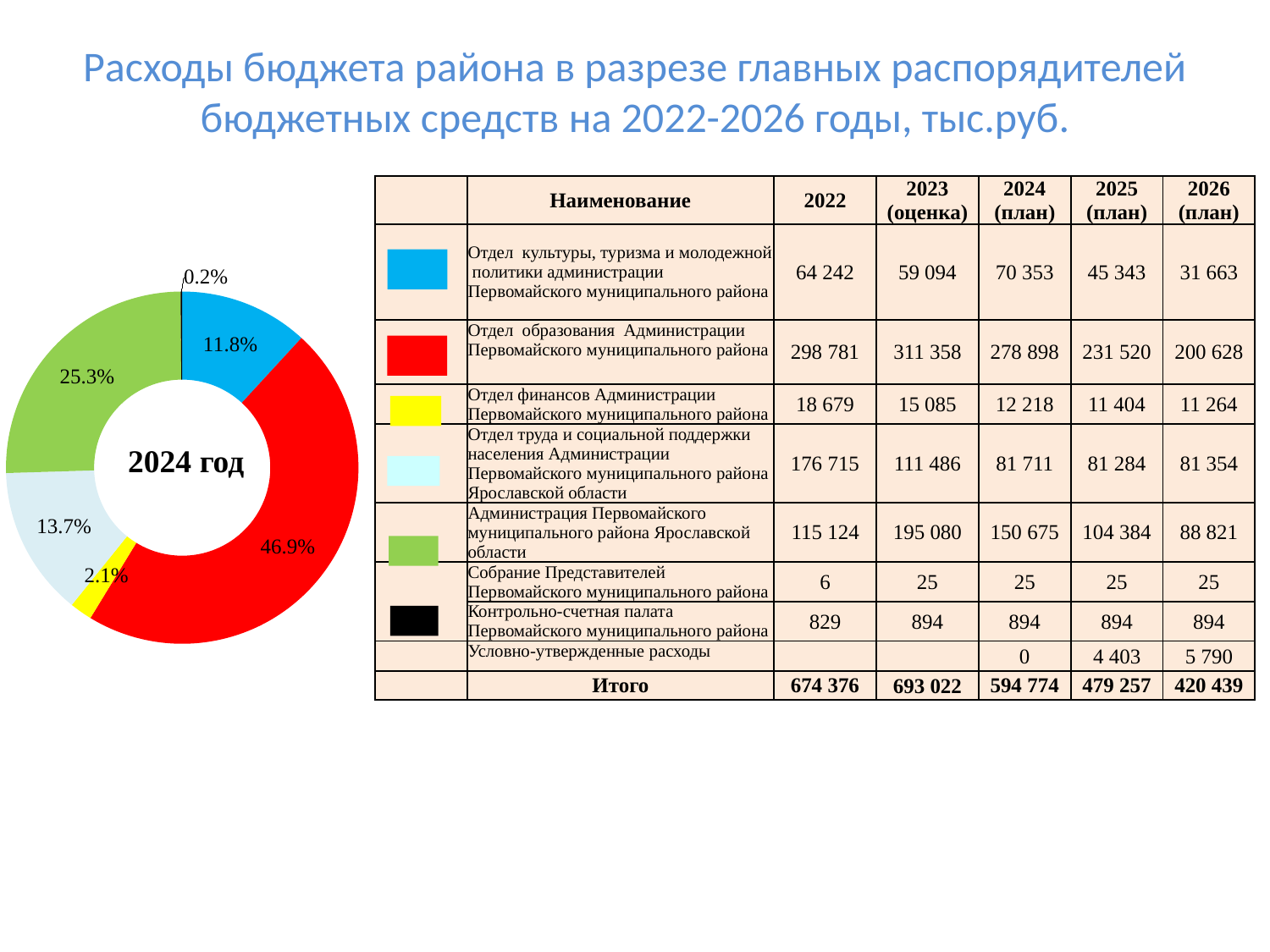
In the doughnut chart, which is larger: the light blue slice or the blue slice? The light blue slice (13.7%) What kind of chart is shown on the left of the slide? Doughnut (pie) chart By how many percentage points does the red slice (46.9%) exceed the green slice (25.3%) in the doughnut chart? 21.6 percentage points What share of the doughnut chart does the green slice (Администрация Первомайского муниципального района) take? 25.3% What share of the doughnut chart does the light blue slice (Отдел труда и социальной поддержки населения) take? 13.7% What share of the doughnut chart does the yellow slice (Отдел финансов) take? 2.1% Which slice of the doughnut chart is the largest? Red (Отдел образования), 46.9% Which year does the doughnut chart represent, according to the label in its centre? 2024 год